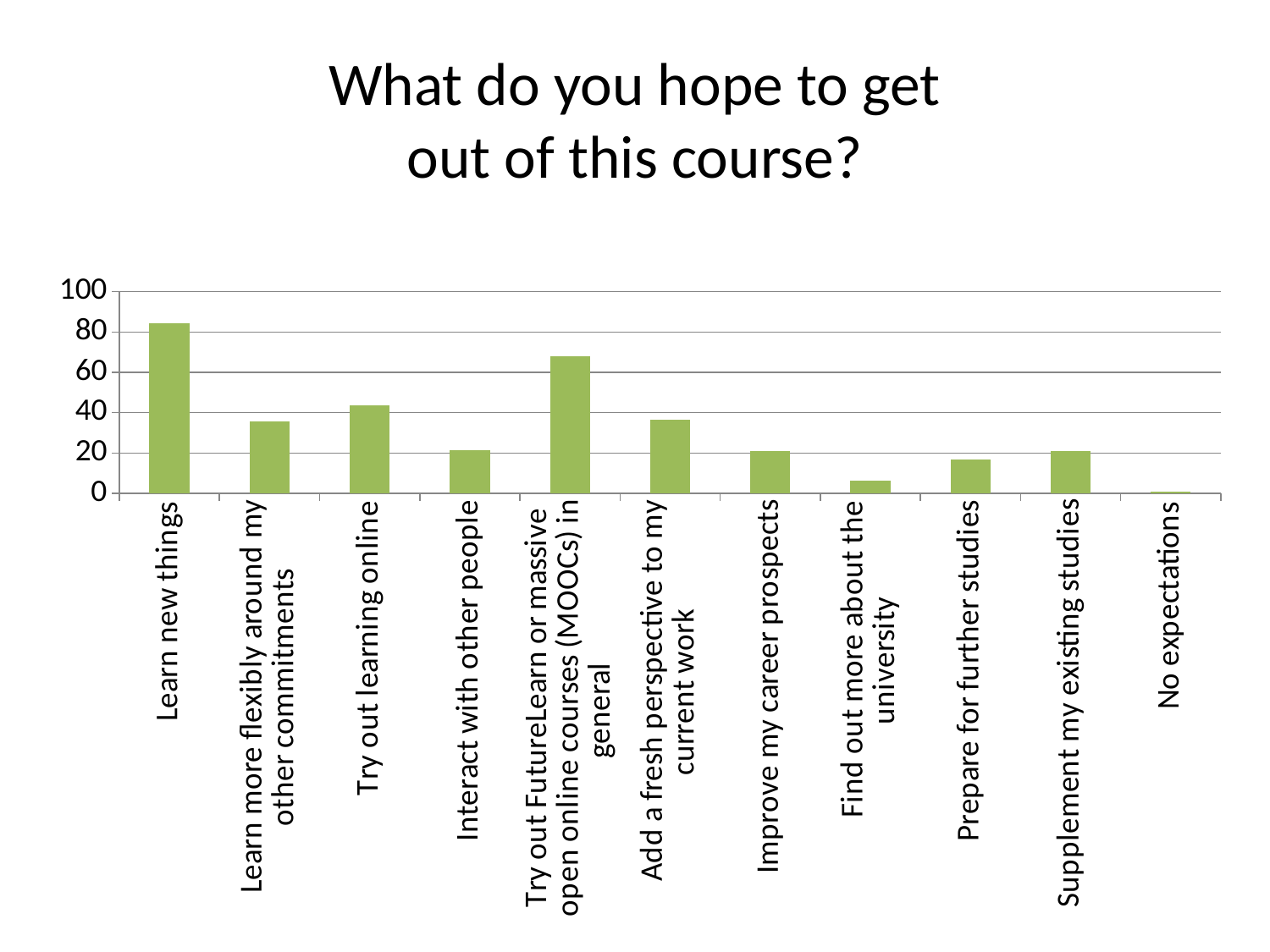
What colour are the bars in the chart? green What is the title of the chart? What do you hope to get out of this course? Which category has the highest value? Learn new things Which category has the lowest value? No expectations Which is larger: the value for Learn new things or the value for Try out FutureLearn or massive open online courses (MOOCs) in general? Learn new things What kind of chart is shown on the slide? bar chart Which is larger: the value for Try out learning online or the value for Learn more flexibly around my other commitments? Try out learning online Is the value for Learn new things greater or less than 60? greater Is the value for Try out FutureLearn or massive open online courses (MOOCs) in general greater or less than 60? greater How many categories are plotted on the x axis? 11 Is the value for Learn more flexibly around my other commitments greater or less than 40? less